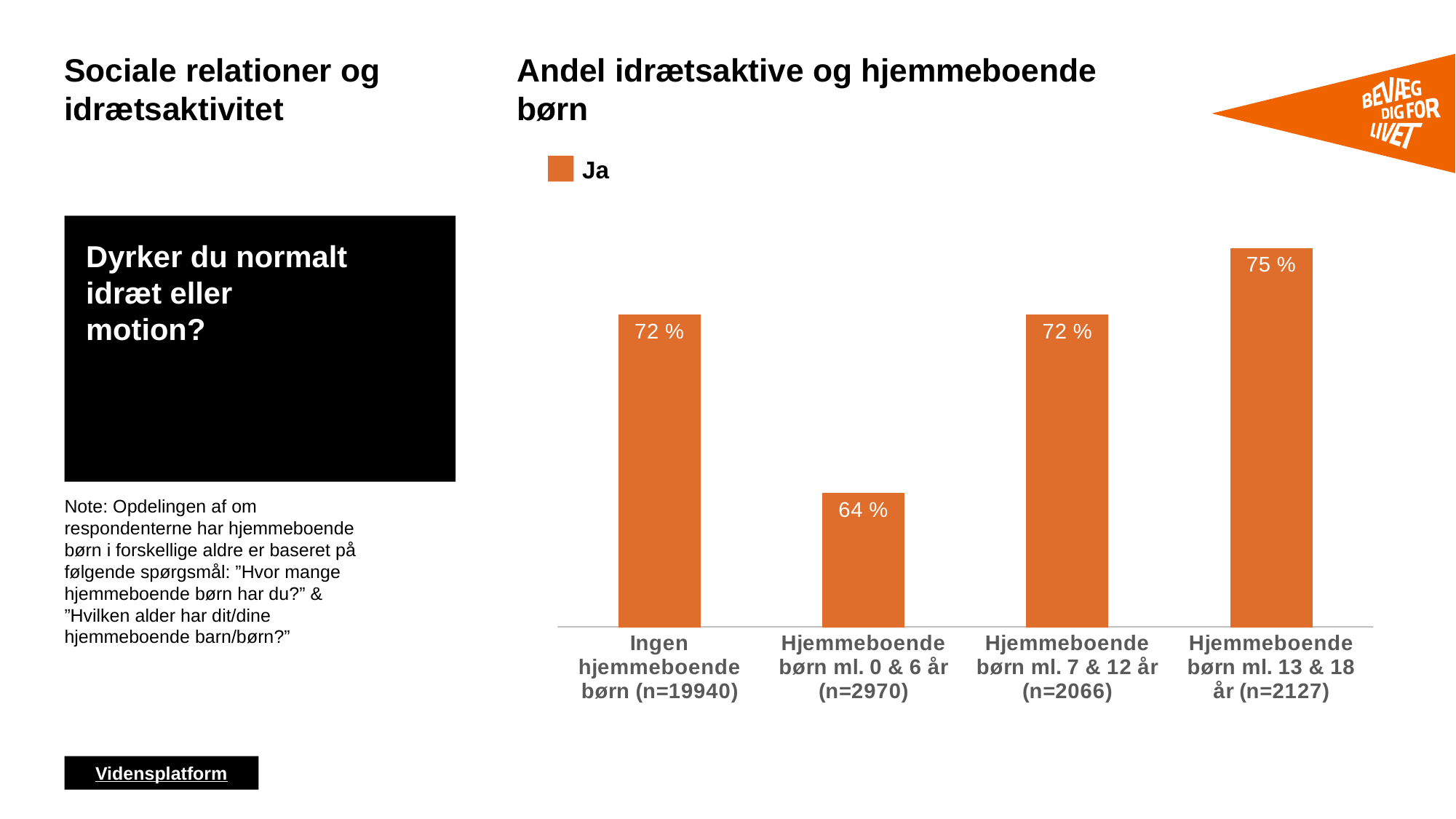
Which category has the highest value? Hjemmeboende børn ml. 13 & 18 år (n=2127) What is the value for 'Ingen hjemmeboende børn (n=19940)'? 72 % What kind of chart is shown? Bar chart What is the title of the chart? Andel idrætsaktive og hjemmeboende børn What is the difference between the values for 'Hjemmeboende børn ml. 13 & 18 år (n=2127)' and 'Hjemmeboende børn ml. 0 & 6 år (n=2970)'? 11 % Which category has the lowest value? Hjemmeboende børn ml. 0 & 6 år (n=2970) What is the value for 'Hjemmeboende børn ml. 7 & 12 år (n=2066)'? 72 % How many series does the legend list? 1 What is the value for 'Hjemmeboende børn ml. 0 & 6 år (n=2970)'? 64 % How many categories are shown in the chart? 4 What is the value for 'Hjemmeboende børn ml. 13 & 18 år (n=2127)'? 75 % Which is larger: the value for 'Hjemmeboende børn ml. 13 & 18 år (n=2127)' or 'Ingen hjemmeboende børn (n=19940)'? Hjemmeboende børn ml. 13 & 18 år (n=2127)